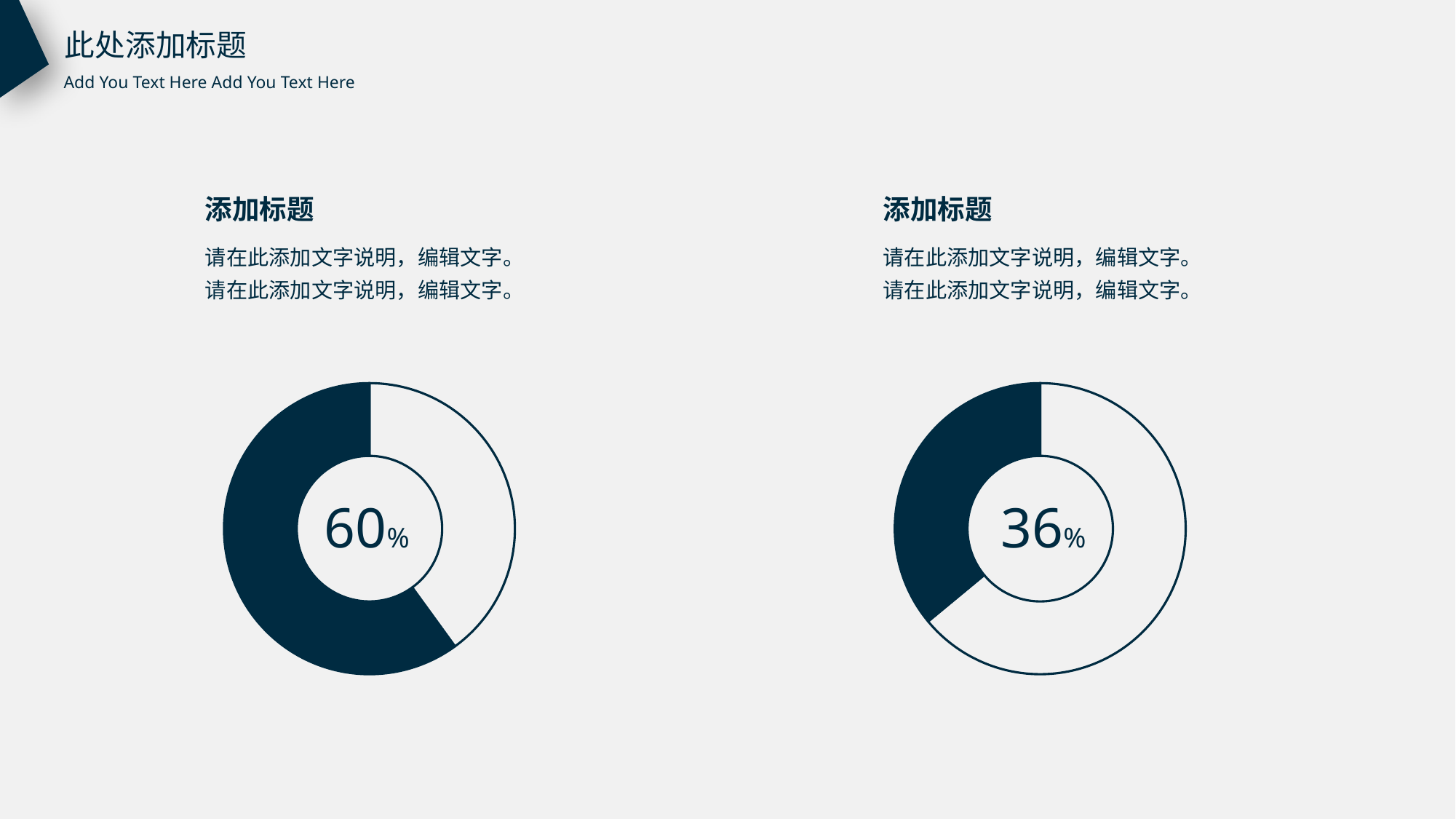
What kind of chart is used on the right side of the slide? donut chart What kind of chart is used on the left side of the slide? donut chart What colour is the filled segment of each donut chart? dark navy blue How many donut charts are on the slide? 2 Is the value shown on the right donut chart greater or less than 50%? less On the left donut chart, what share of the ring is not filled by the dark segment? 40% On the right donut chart, what share of the ring is not filled by the dark segment? 64% What is the difference between the percentage on the left donut chart and the percentage on the right donut chart? 24 percentage points What percentage is shown in the centre of the right donut chart? 36% What percentage is shown in the centre of the left donut chart? 60% Is the value shown on the left donut chart greater or less than 50%? greater Which donut chart shows the larger percentage, the left one or the right one? the left one